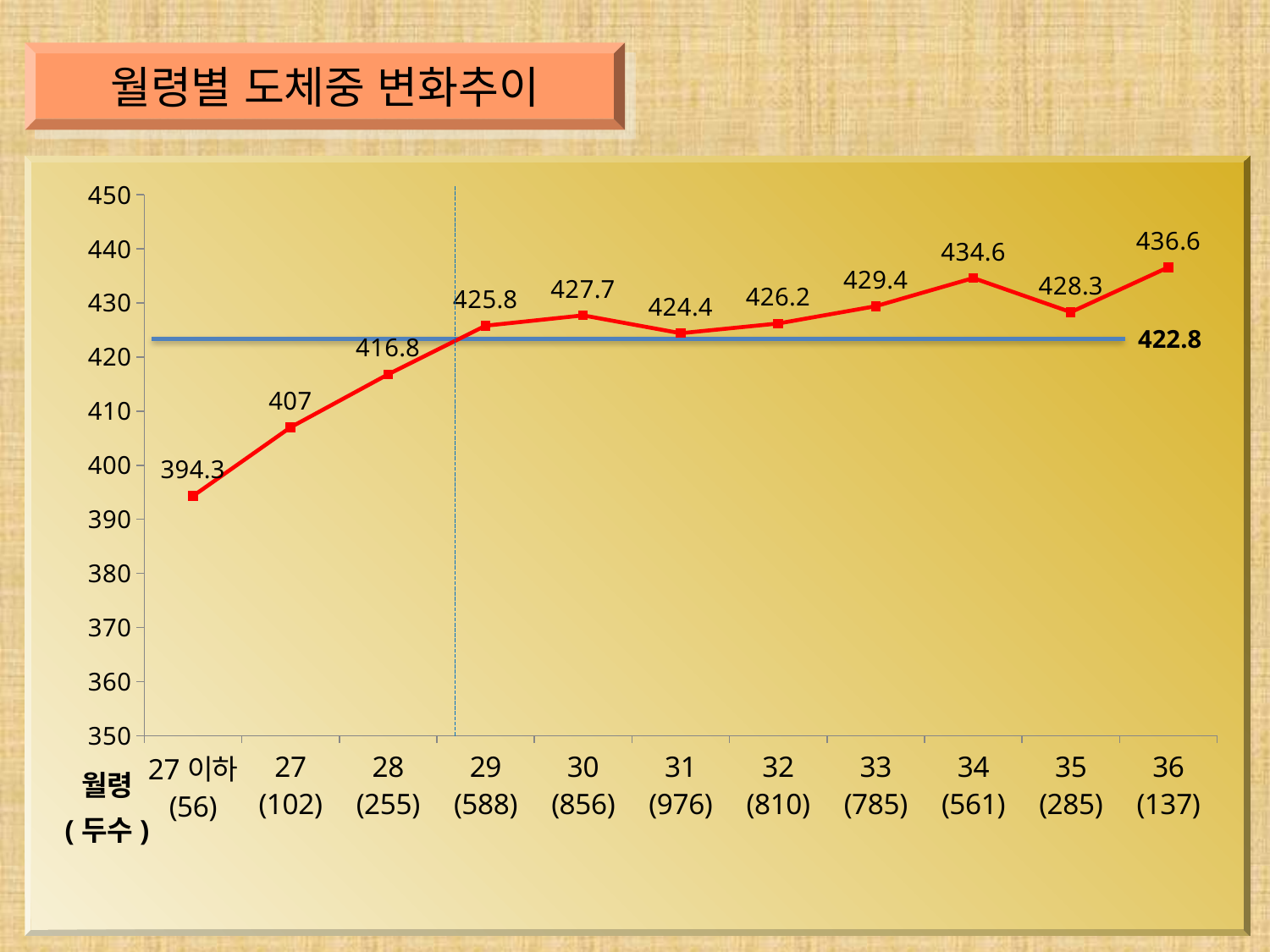
How many categories are shown on the x axis? 11 What is the value for the '27 이하 (56)' category? 394.3 What value is labelled on the horizontal blue reference line? 422.8 Which category has the lowest value? 27 이하 (56) What is the difference between the values for month 36 and month 35? 8.3 What is the value for month 30 (856)? 427.7 Is the value for month 28 greater or less than 420? less Do the values generally rise or fall from left to right along the x axis? rise What is the value for month 34 (561)? 434.6 Which category has the highest value? 36 (137) Which is larger, the value for month 29 or the value for month 31? 29 (588) What kind of chart is this? line chart